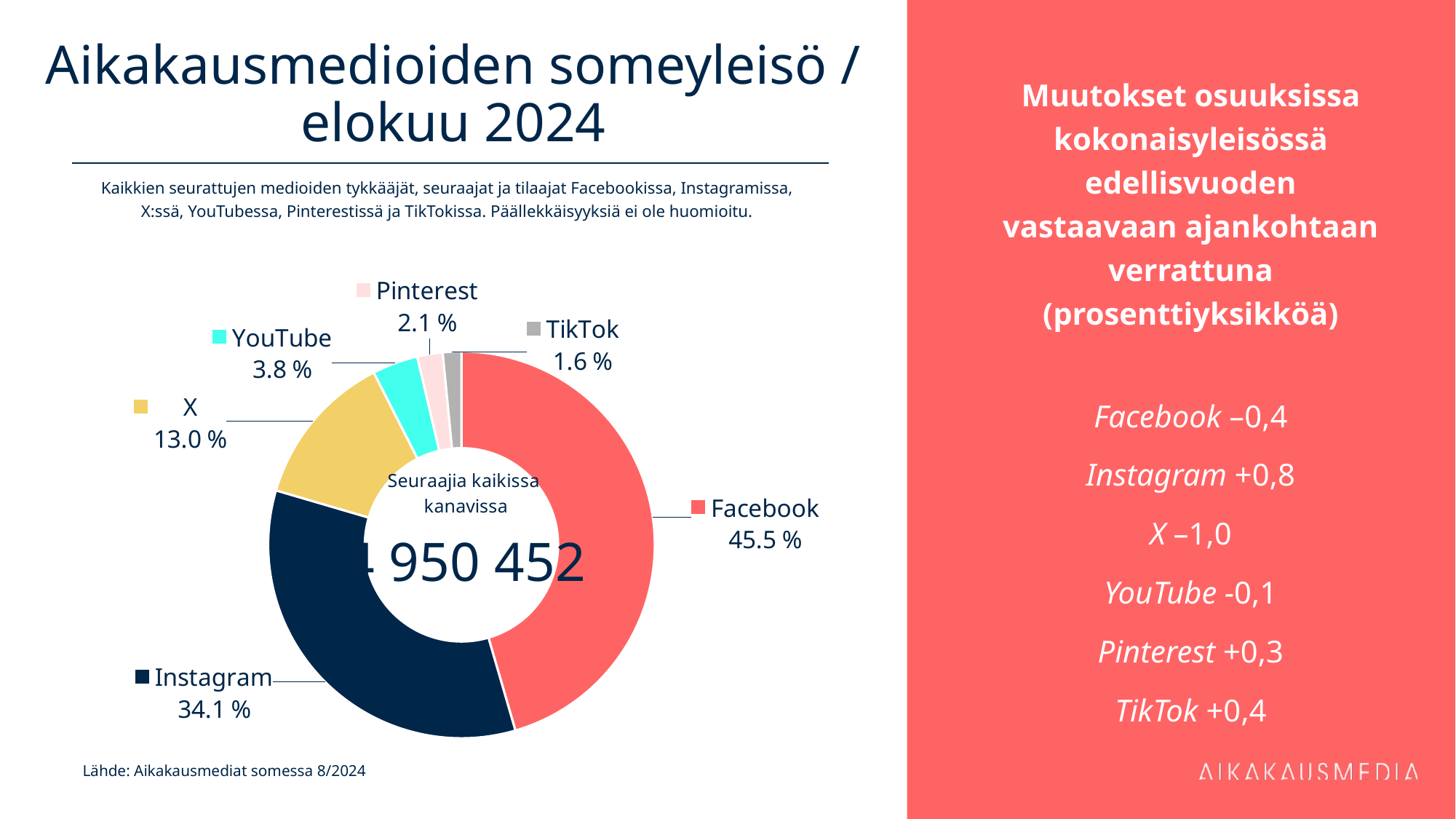
What is the share shown for X in the chart? 13.0 % How many percentage points larger is Facebook's share than Instagram's? 11.4 What percentage does the chart show for YouTube? 3.8 % What percentage is shown for Instagram in the chart? 34.1 % What share is shown for Pinterest? 2.1 % How many channels are shown in the chart? 6 What is the combined share of Facebook and Instagram? 79.6 % Which channel has the largest share in the chart? Facebook Which channel has the smallest share in the chart? TikTok What type of chart is used on the slide? Donut (pie) chart What share of the social media audience does Facebook hold in the donut chart? 45.5 % Which has a larger share, X or YouTube? X